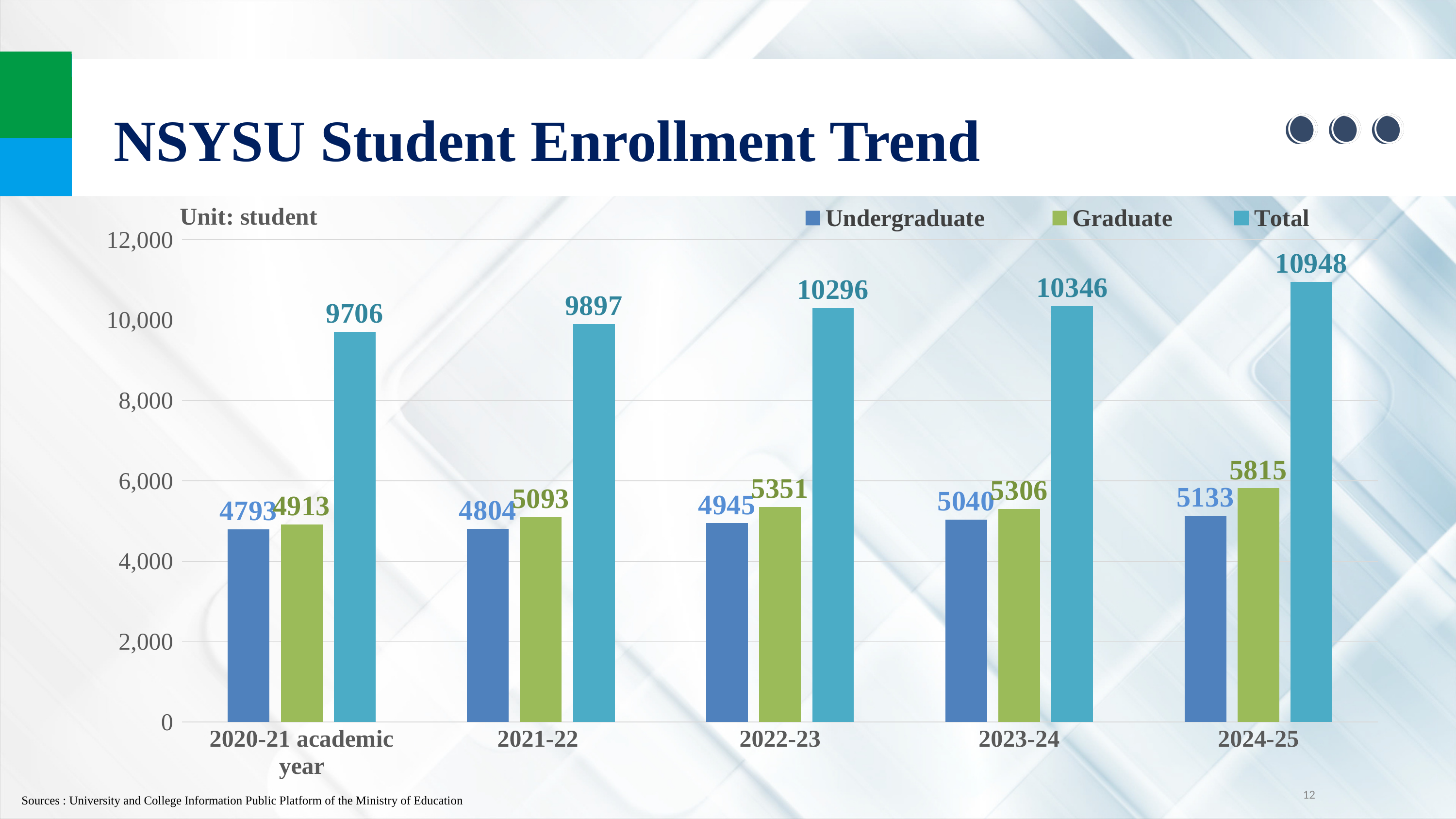
Which academic year has the lowest Graduate enrollment? 2020-21 academic year What is the Total enrollment for 2024-25? 10948 How many academic years are shown on the x axis? 5 Which academic year has the highest Total enrollment? 2024-25 What kind of chart is shown on the slide? bar chart What is the Undergraduate enrollment for 2022-23? 4945 What is the difference between the Total enrollment in 2024-25 and in 2020-21? 1242 What is the Graduate enrollment for 2021-22? 5093 Which is larger in 2023-24, Undergraduate or Graduate enrollment? Graduate Does the Total enrollment rise or fall from 2020-21 to 2024-25? rise Is the Total enrollment for 2021-22 greater or less than 10,000? less How many series does the legend list? 3